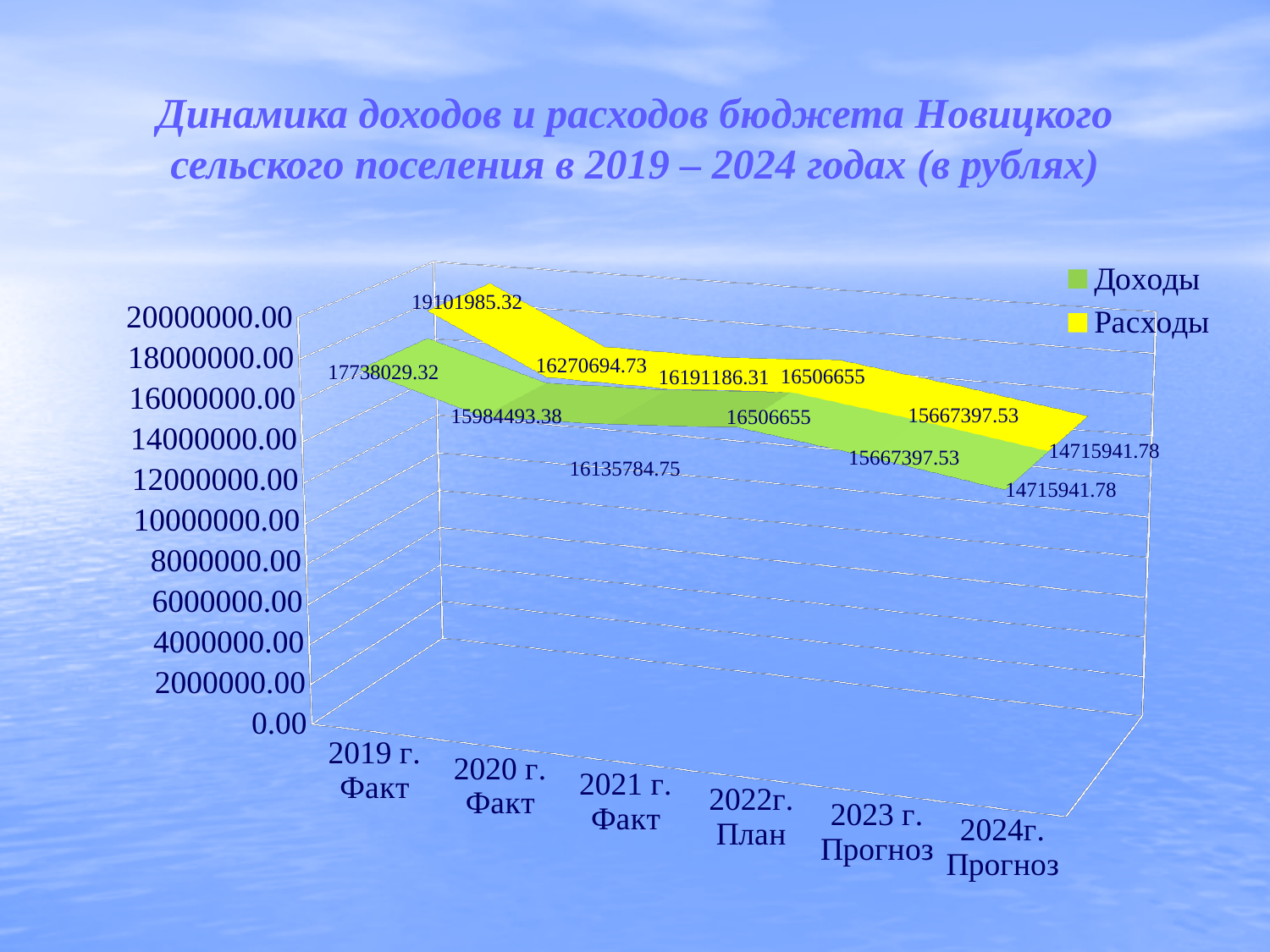
How many series does the legend list? 2 What is the value of Расходы for 2019 г. Факт? 19101985.32 What is the difference between Расходы and Доходы for 2019 г. Факт? 1363956.00 How many categories (years) are shown on the x axis? 6 In which year is Доходы the lowest? 2024г. Прогноз For 2020 г. Факт, which is larger: Доходы or Расходы? Расходы What is the value of Доходы for 2024г. Прогноз? 14715941.78 In which year is Расходы the highest? 2019 г. Факт What is the value of Расходы for 2021 г. Факт? 16191186.31 What is the value of Доходы for 2019 г. Факт? 17738029.32 What is the value of Доходы for 2020 г. Факт? 15984493.38 Do the Расходы values rise or fall from 2019 г. Факт to 2024г. Прогноз? fall